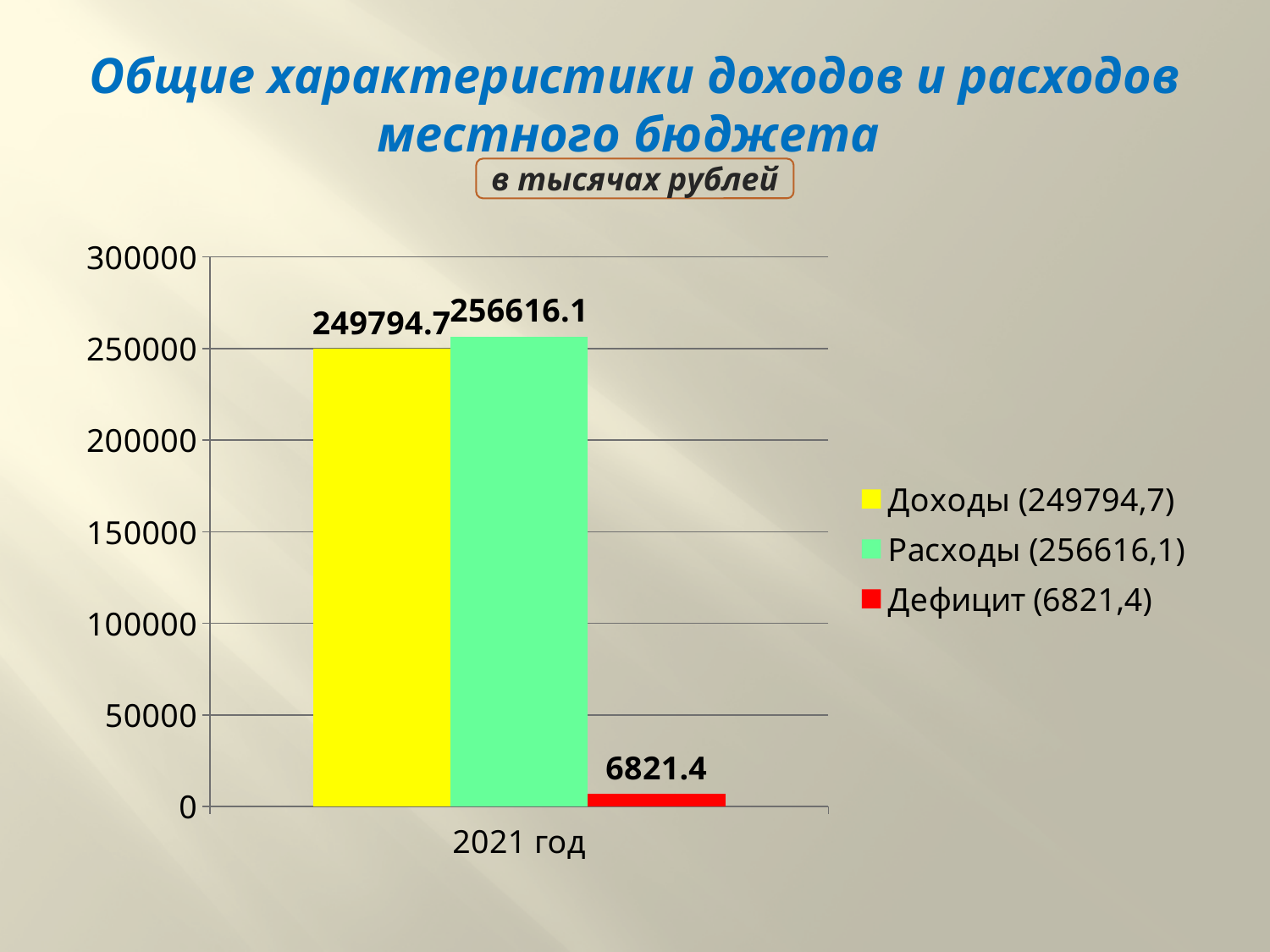
What kind of chart is shown on the slide? bar chart What is the difference between the Расходы and Доходы values? 6821.4 What is the value of the Расходы bar for 2021 год? 256616.1 Which series has the highest value in the chart? Расходы Which series has the lowest value in the chart? Дефицит What is the value of the Дефицит bar for 2021 год? 6821.4 What colour is the Дефицит bar? red Is the value for Расходы greater or less than 250000? greater How many series does the legend list? 3 Which is larger, Доходы or Расходы? Расходы Is the value for Дефицит greater or less than 50000? less What is the value of the Доходы bar for 2021 год? 249794.7